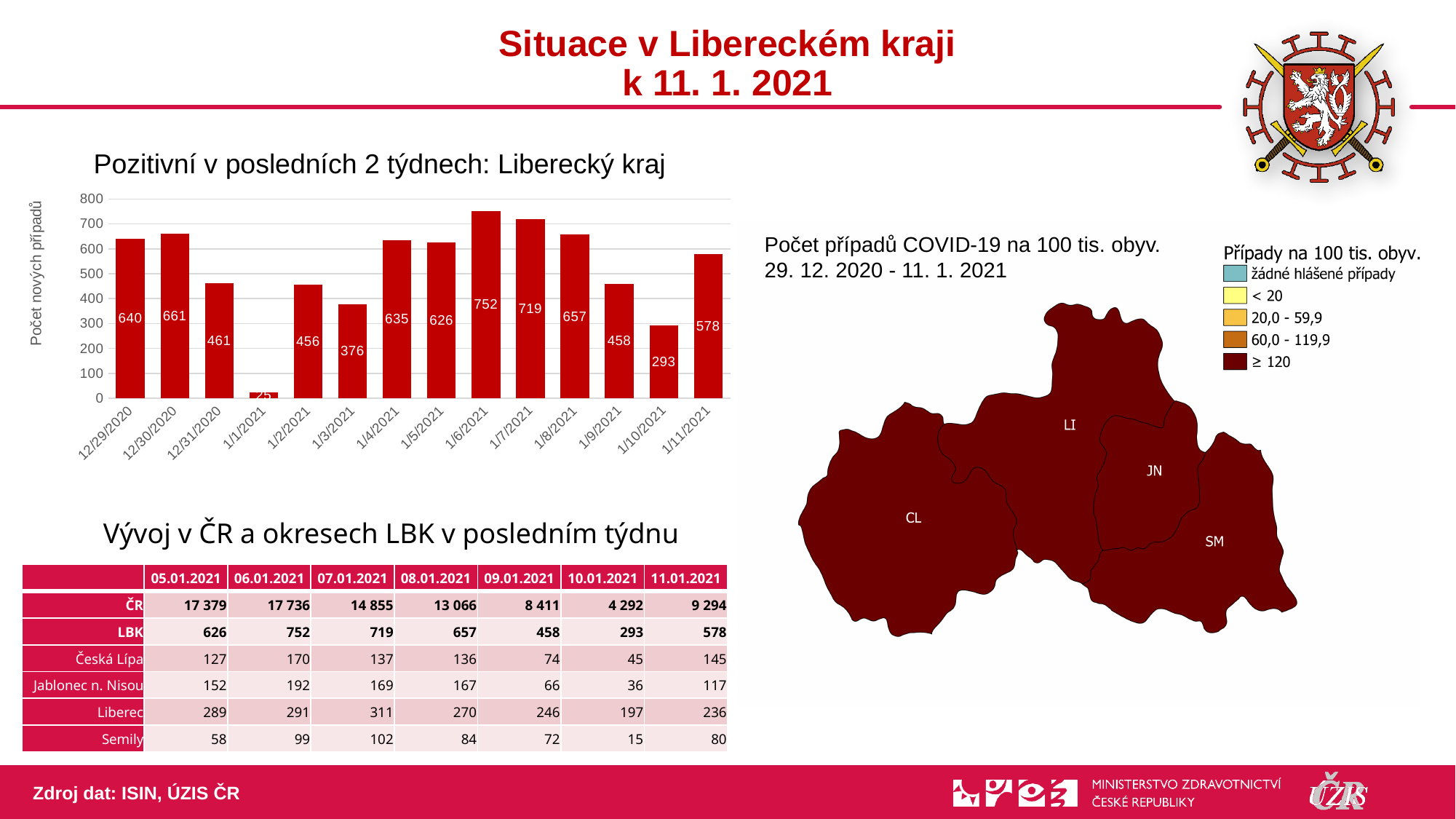
What kind of chart is 'Pozitivní v posledních 2 týdnech: Liberecký kraj'? bar chart In the chart 'Pozitivní v posledních 2 týdnech: Liberecký kraj', what is the value for 12/29/2020? 640 In the chart 'Pozitivní v posledních 2 týdnech: Liberecký kraj', what is the value for 1/6/2021? 752 How many dates (bars) are shown in the chart 'Pozitivní v posledních 2 týdnech: Liberecký kraj'? 14 In the chart 'Pozitivní v posledních 2 týdnech: Liberecký kraj', which date has the lowest number of new cases? 1/1/2021 In the chart 'Pozitivní v posledních 2 týdnech: Liberecký kraj', which date has the highest number of new cases? 1/6/2021 In the chart 'Pozitivní v posledních 2 týdnech: Liberecký kraj', what is the difference between the values for 1/6/2021 and 1/7/2021? 33 In the chart 'Pozitivní v posledních 2 týdnech: Liberecký kraj', what is the value for 1/10/2021? 293 In the chart 'Pozitivní v posledních 2 týdnech: Liberecký kraj', what is the difference between the values for 12/30/2020 and 12/31/2020? 200 What is the y-axis label of the chart 'Pozitivní v posledních 2 týdnech: Liberecký kraj'? Počet nových případů In the chart 'Pozitivní v posledních 2 týdnech: Liberecký kraj', is the value for 1/11/2021 greater or less than 500? greater In the chart 'Pozitivní v posledních 2 týdnech: Liberecký kraj', which is larger, the value for 1/4/2021 or the value for 1/5/2021? 1/4/2021